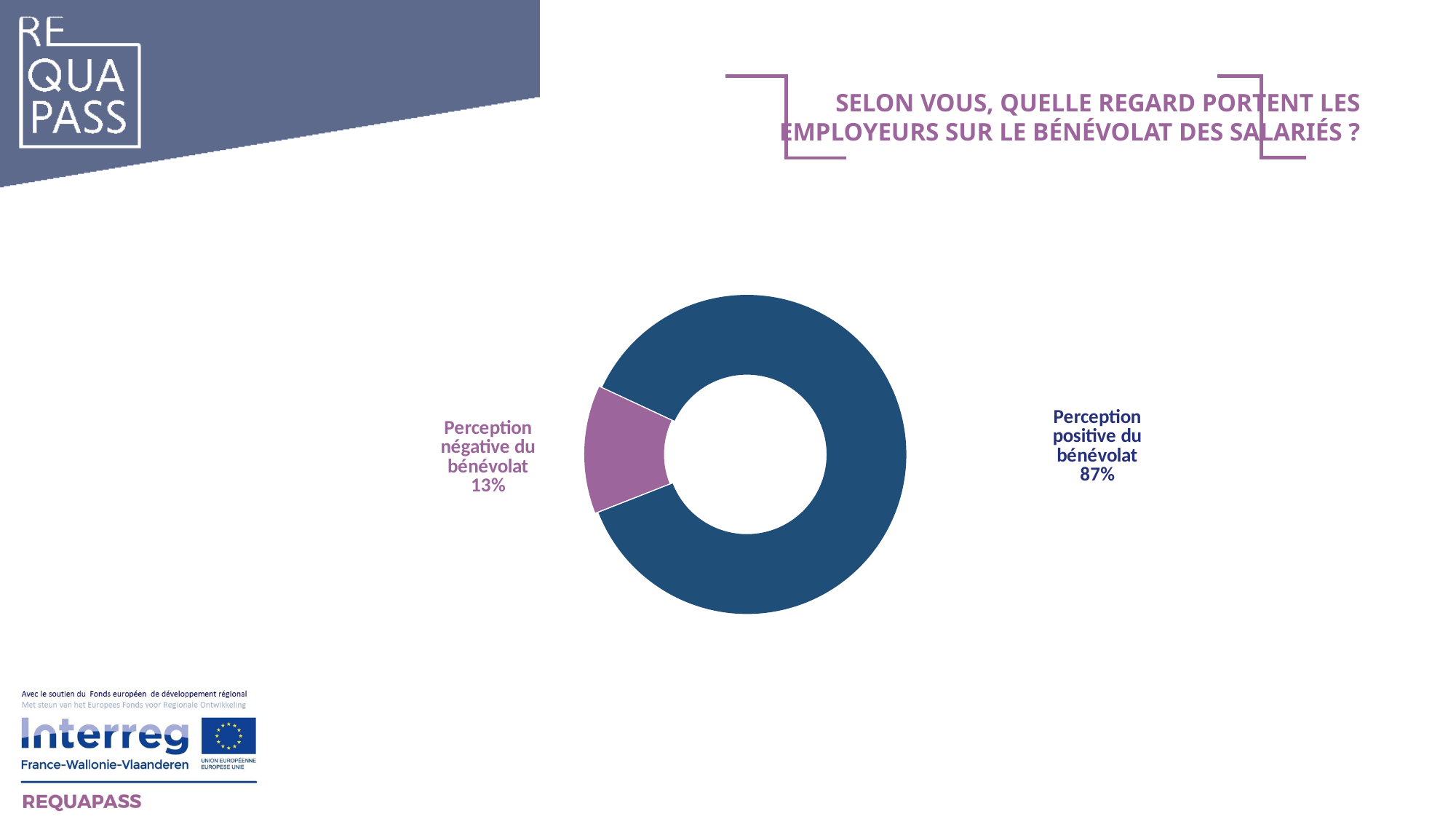
What is the difference in percentage points between the positive and negative perception shares? 74 What percentage of respondents have a positive perception of volunteering (Perception positive du bénévolat)? 87% Which is larger: the share for Perception positive du bénévolat or Perception négative du bénévolat? Perception positive du bénévolat Which category has the largest share of the chart? Perception positive du bénévolat What is the total of the two percentages shown in the chart? 100% What kind of chart is shown on the slide? Doughnut (pie) chart What question does the slide title ask? Selon vous, quelle regard portent les employeurs sur le bénévolat des salariés ? What colour is the Perception négative du bénévolat slice? Purple What percentage of respondents have a negative perception of volunteering (Perception négative du bénévolat)? 13% How many categories are shown in the chart? 2 What share of the chart does the Perception négative du bénévolat slice represent? 13% Which category has the smallest share of the chart? Perception négative du bénévolat